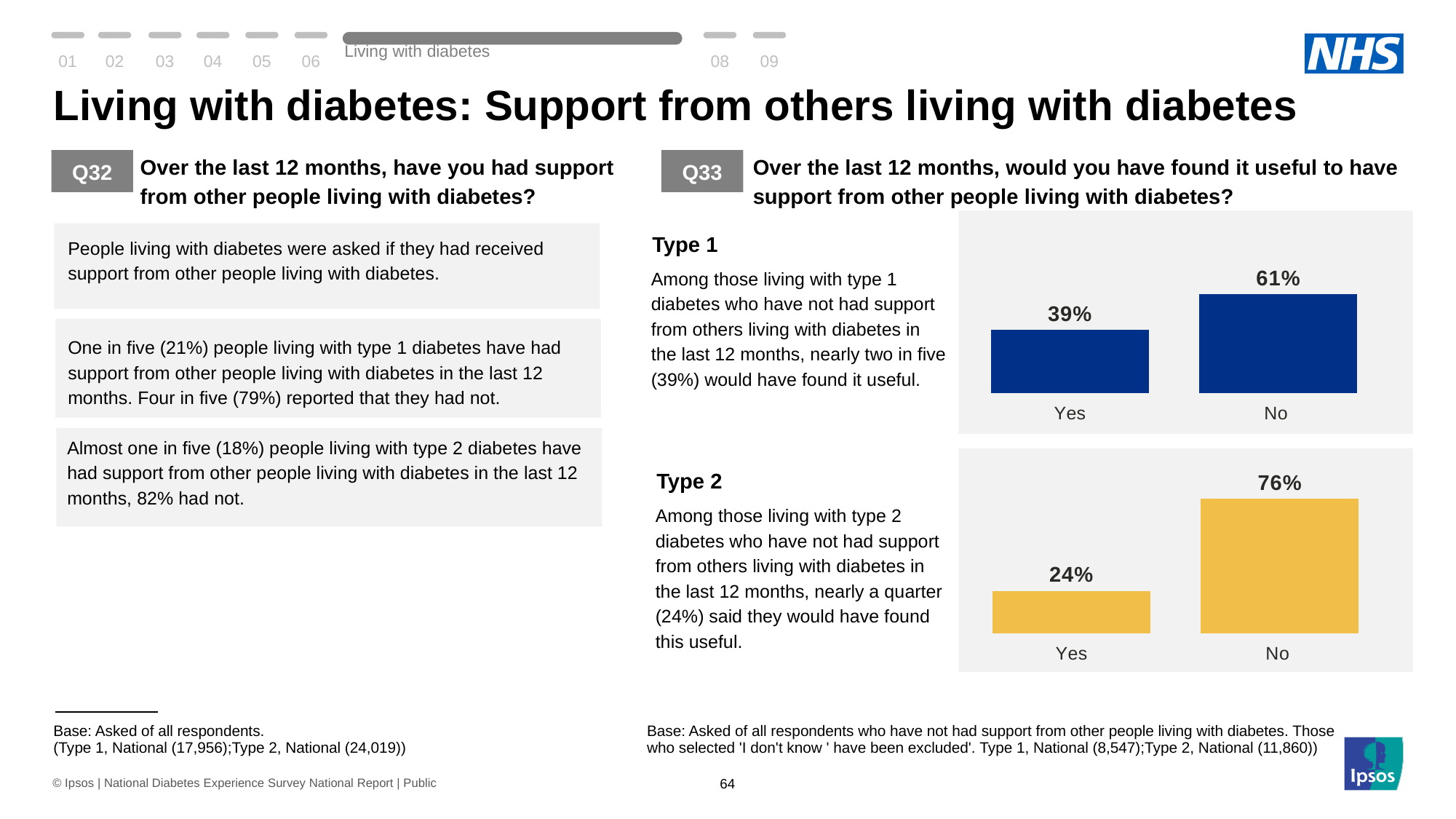
In the Type 2 chart, what is the difference between the No and Yes values? 52% In the Type 2 chart, which category has the lower value? Yes How many categories are shown in the Type 2 chart? 2 Which is larger: the Yes value in the Type 1 chart or the Yes value in the Type 2 chart? Type 1 chart In the Type 1 chart, which category has the higher value? No In the Type 1 chart, what percentage answered Yes? 39% What colour are the bars in the Type 2 chart? Yellow In the Type 2 chart, what percentage answered No? 76% In the Type 2 chart, what percentage answered Yes? 24% In the Type 1 chart, what is the difference between the No and Yes values? 22% What kind of chart is the Type 1 chart? Bar chart In the Type 1 chart, what percentage answered No? 61%